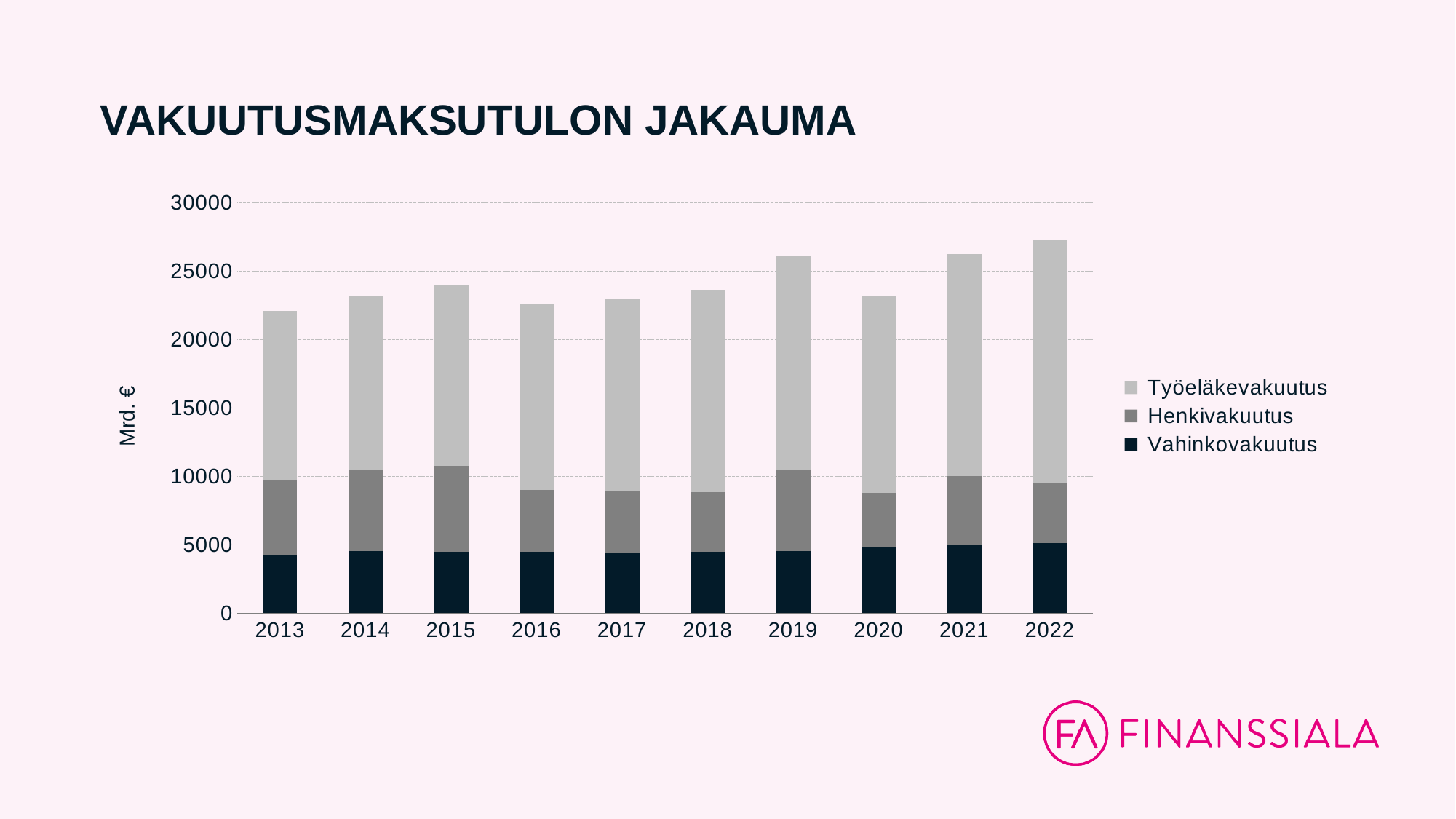
What kind of chart is shown on the slide? Stacked bar chart How many years are shown on the x axis of the chart? 10 Do the total bars generally rise or fall from 2013 to 2022? rise How many series does the legend list? 3 Is the total bar for 2016 greater or less than 20000? greater Which year has the highest total bar? 2022 What is the title of the chart? VAKUUTUSMAKSUTULON JAKAUMA Is the total bar for 2013 greater or less than 25000? less What is the label on the y axis? Mrd. € Is the total bar for 2022 greater or less than 25000? greater Which year has the larger total bar, 2019 or 2020? 2019